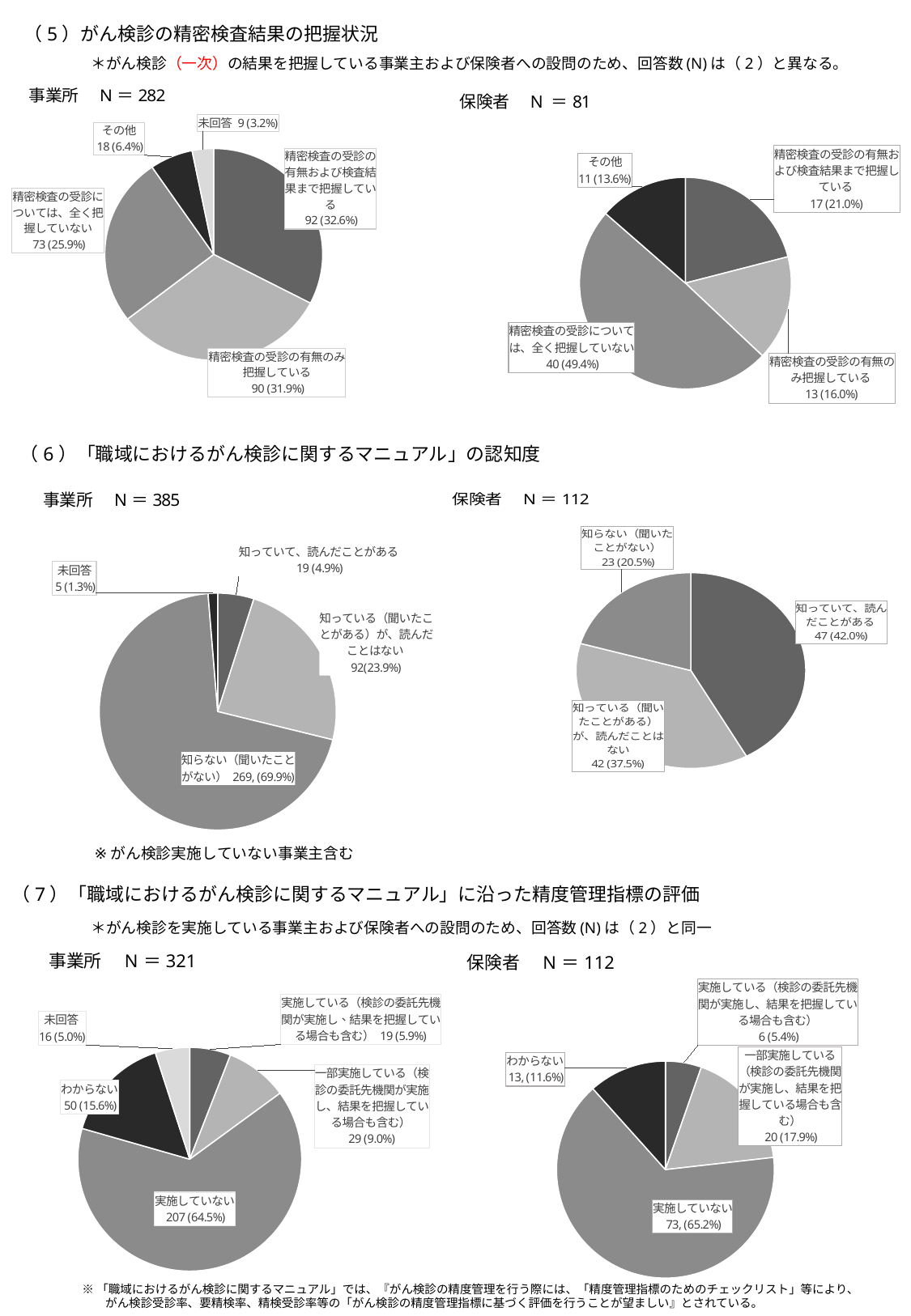
（7）保険者の円グラフには、いくつの区分（スライス）がありますか？ 4 （5）保険者の円グラフで、「その他」の割合は何％ですか？ 13.6% （6）保険者の円グラフで、最も割合が小さい回答はどれですか？ 知らない（聞いたことがない） （5）保険者の円グラフで、最も割合が大きい回答はどれですか？ 精密検査の受診については、全く把握していない （7）事業所の円グラフで、「わからない」と「未回答」ではどちらの回答数が多いですか？ わからない このスライドのグラフはどの種類のグラフですか？ 円グラフ （7）保険者の円グラフで、「一部実施している」の回答数と割合はいくつですか？ 20 (17.9%) （7）事業所の円グラフで、「実施していない」の割合は何％ですか？ 64.5% （6）事業所の円グラフで、「知らない（聞いたことがない）」の回答数はいくつですか？ 269 （5）事業所の円グラフには、いくつの区分（スライス）がありますか？ 5 （6）保険者の円グラフで、「知っていて、読んだことがある」と「知っている（聞いたことがある）が、読んだことはない」の回答数の差はいくつですか？ 5 （5）事業所の円グラフで、「精密検査の受診の有無および検査結果まで把握している」の回答数と割合はいくつですか？ 92 (32.6%)